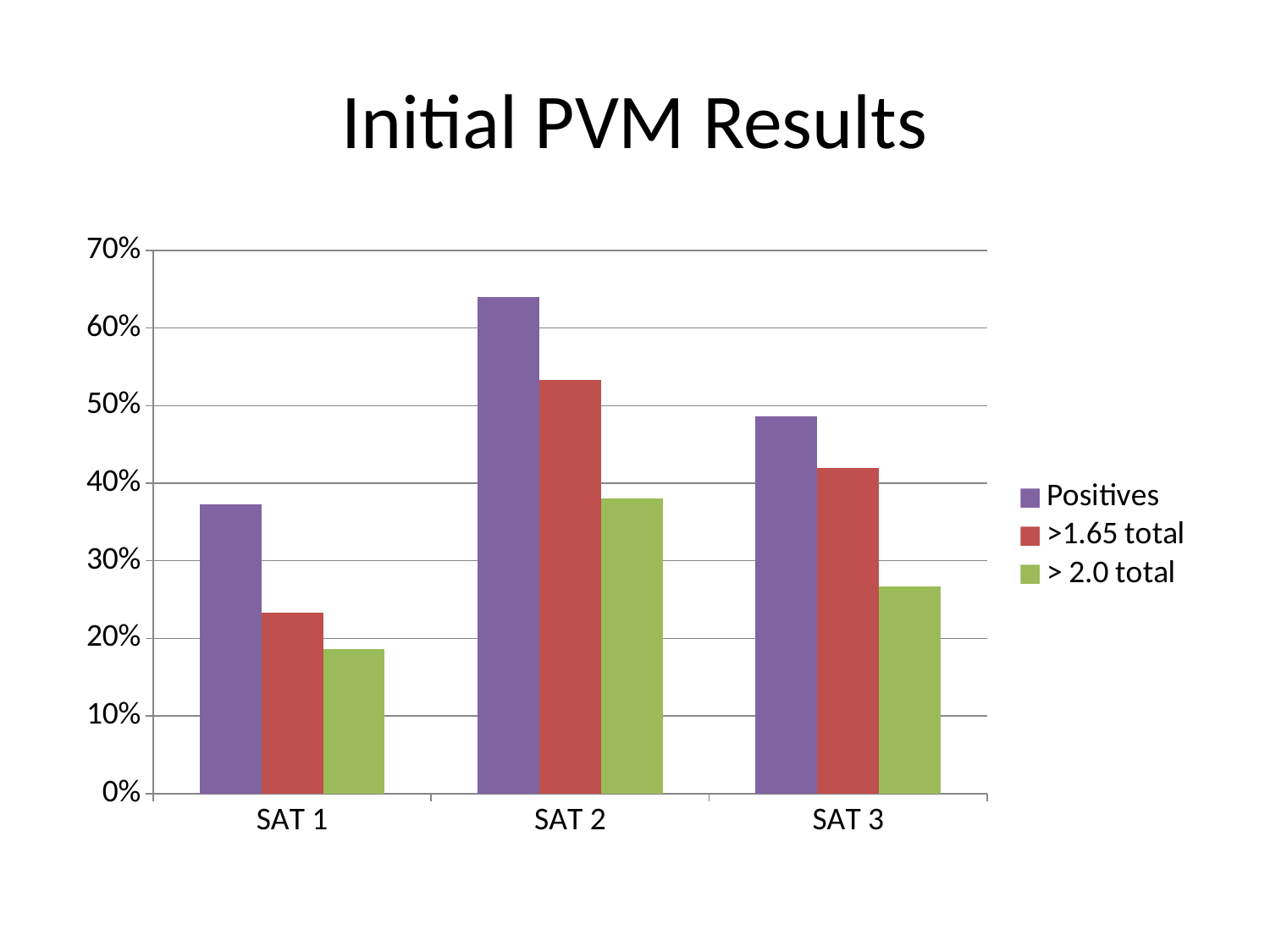
Is the > 2.0 total value for SAT 3 greater or less than 30%? less Is the Positives value for SAT 1 greater or less than 40%? less Is the Positives value for SAT 2 greater or less than 60%? greater Which category has the highest Positives value? SAT 2 How many series does the legend list? 3 Which category has the lowest > 2.0 total value? SAT 1 Which series is shown in green? > 2.0 total How many categories are shown on the x axis? 3 What kind of chart is shown on the slide? bar chart Which is larger, the >1.65 total value for SAT 3 or the >1.65 total value for SAT 1? SAT 3 What is the title of the chart on the slide? Initial PVM Results